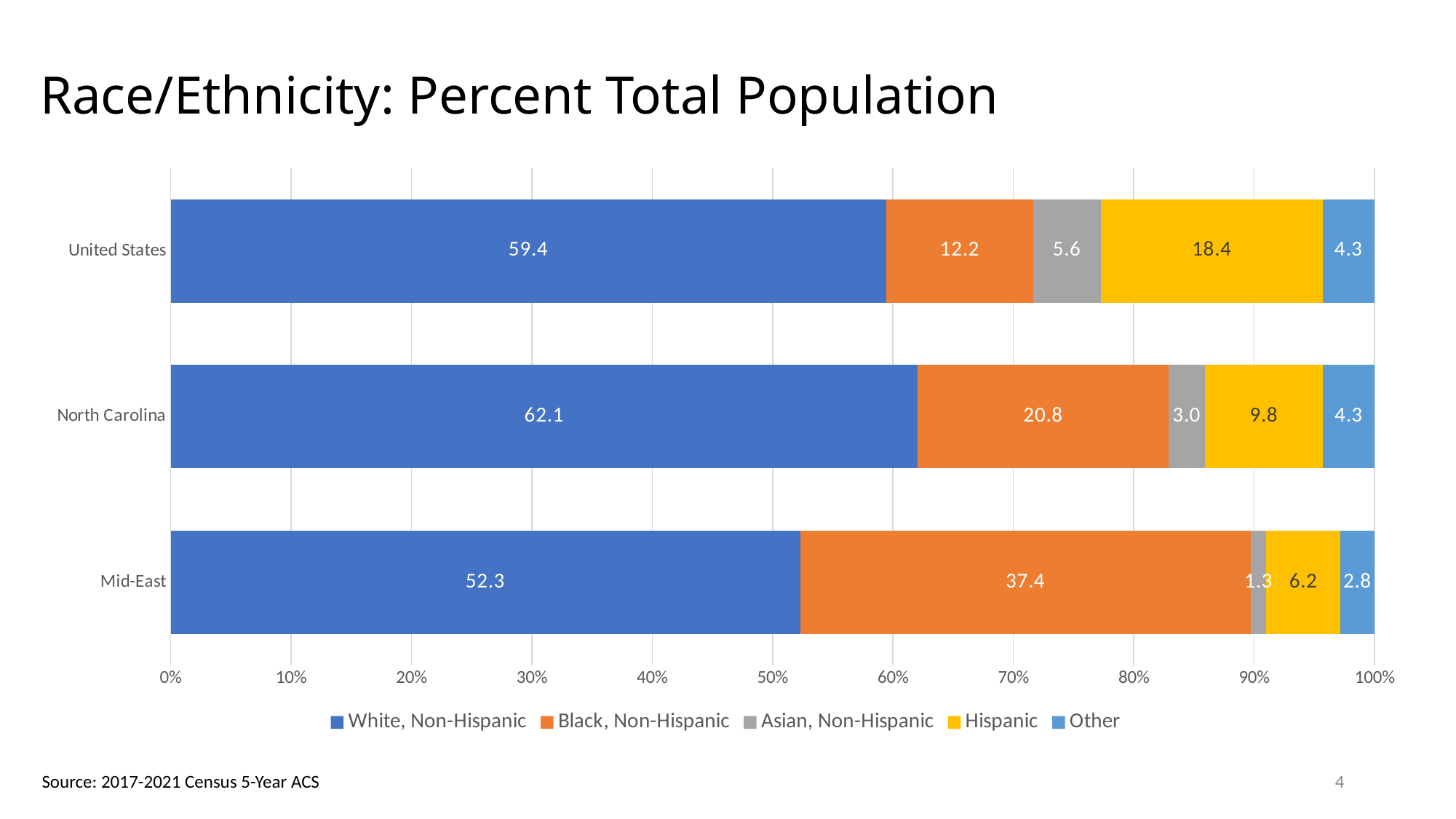
How many regions are shown on the chart? 3 What is the difference between the Black, Non-Hispanic values for Mid-East and the United States? 25.2 What is the White, Non-Hispanic value for North Carolina? 62.1 Which region has the lowest Hispanic value? Mid-East What is the Hispanic value for the United States? 18.4 What is the Asian, Non-Hispanic value for Mid-East? 1.3 What is the Black, Non-Hispanic value for Mid-East? 37.4 Which is larger, the Hispanic value for the United States or for North Carolina? United States What kind of chart is shown on the slide? Stacked bar chart Which region has the highest White, Non-Hispanic value? North Carolina What is the title of the chart? Race/Ethnicity: Percent Total Population How many series does the legend list? 5